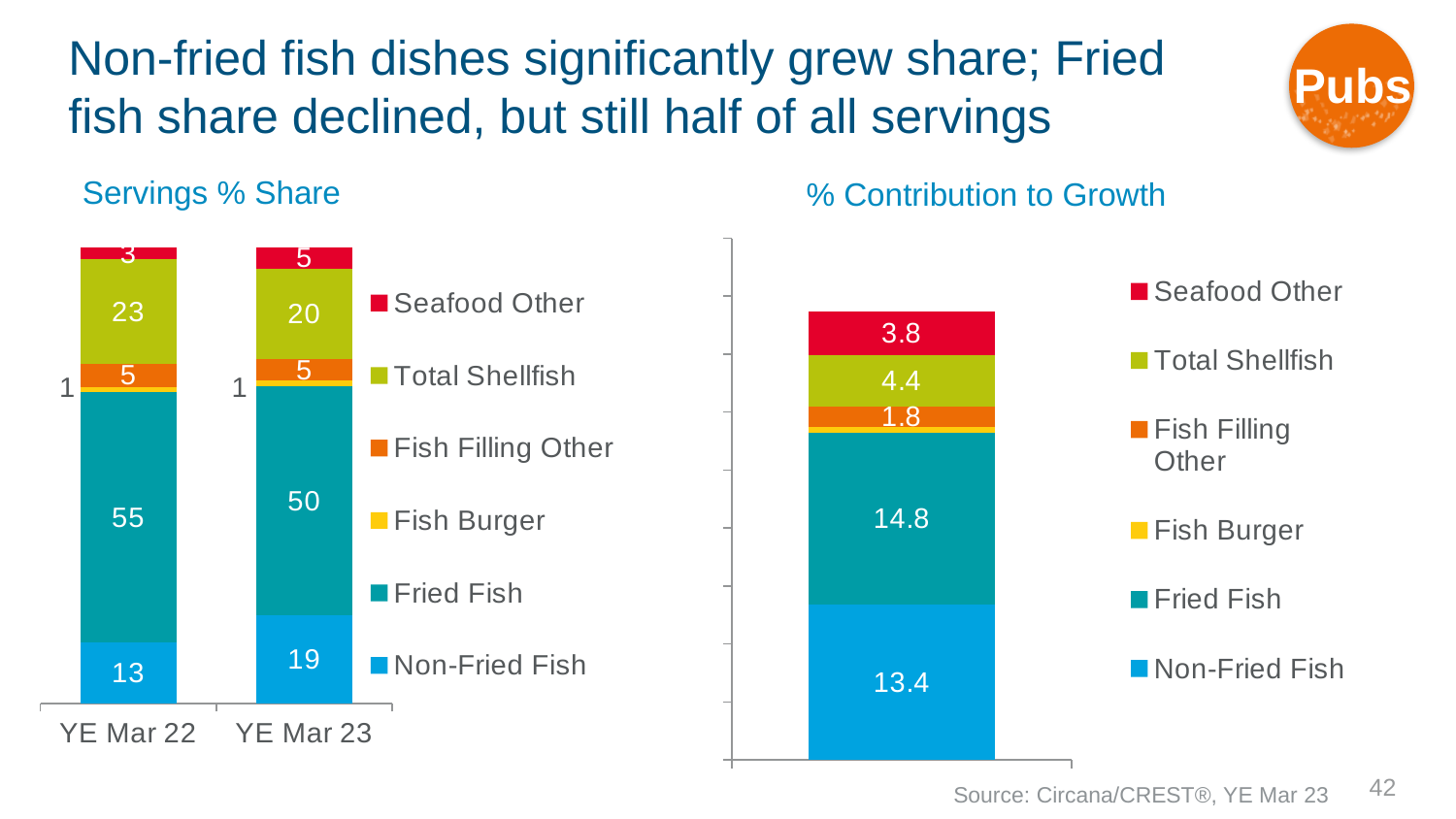
In the Servings % Share chart, what is the value for Total Shellfish in YE Mar 23? 20 In the Servings % Share chart, does the Non-Fried Fish share rise or fall from YE Mar 22 to YE Mar 23? rise In the Servings % Share chart, what is the value for Non-Fried Fish in YE Mar 23? 19 In the % Contribution to Growth chart, which is larger, Total Shellfish or Seafood Other? Total Shellfish In the Servings % Share chart, by how much did the Fried Fish share fall from YE Mar 22 to YE Mar 23? 5 How many series does the legend of the Servings % Share chart list? 6 In the Servings % Share chart, how many time periods are shown on the x axis? 2 In the % Contribution to Growth chart, which segment has the highest value? Fried Fish In the Servings % Share chart, what is the value for Fried Fish in YE Mar 22? 55 In the % Contribution to Growth chart, what is the value for Seafood Other? 3.8 In the Servings % Share chart, what is the total of the YE Mar 22 stacked bar? 100 In the Servings % Share chart, what is the difference in Non-Fried Fish share between YE Mar 23 and YE Mar 22? 6